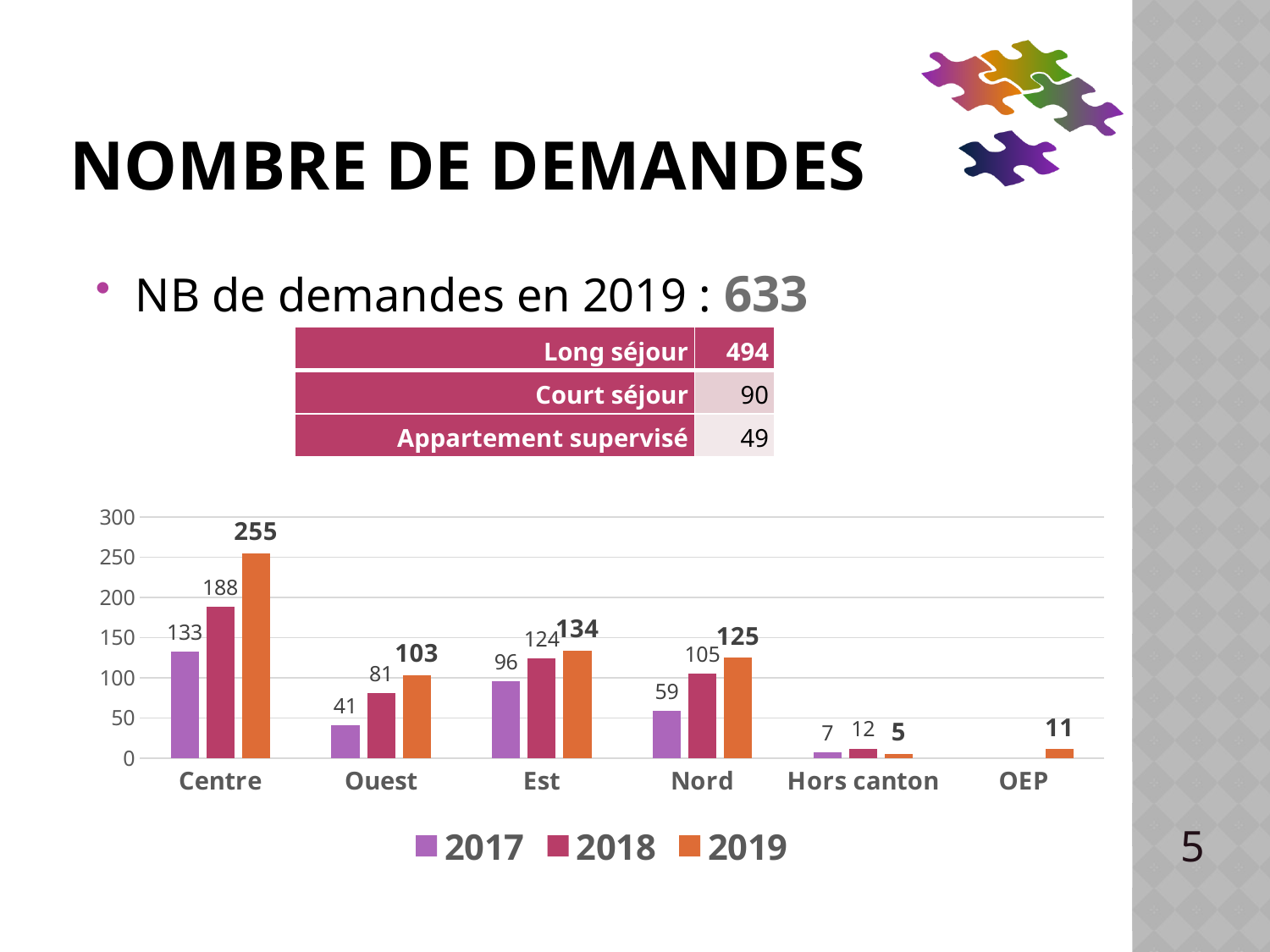
How many categories are shown on the x axis? 6 What is the value for Ouest in 2017? 41 What is the value for OEP in 2019? 11 How many series does the legend list? 3 What is the value for Centre in 2019? 255 For Ouest, do the values rise or fall from 2017 to 2019? Rise What is the value for Nord in 2018? 105 Which category has the lowest value in 2019? Hors canton What kind of chart is shown on the slide? Bar chart What is the difference between the 2019 and 2018 values for Centre? 67 Which is larger, the 2019 value for Est or the 2019 value for Nord? Est Which category has the highest value in 2019? Centre